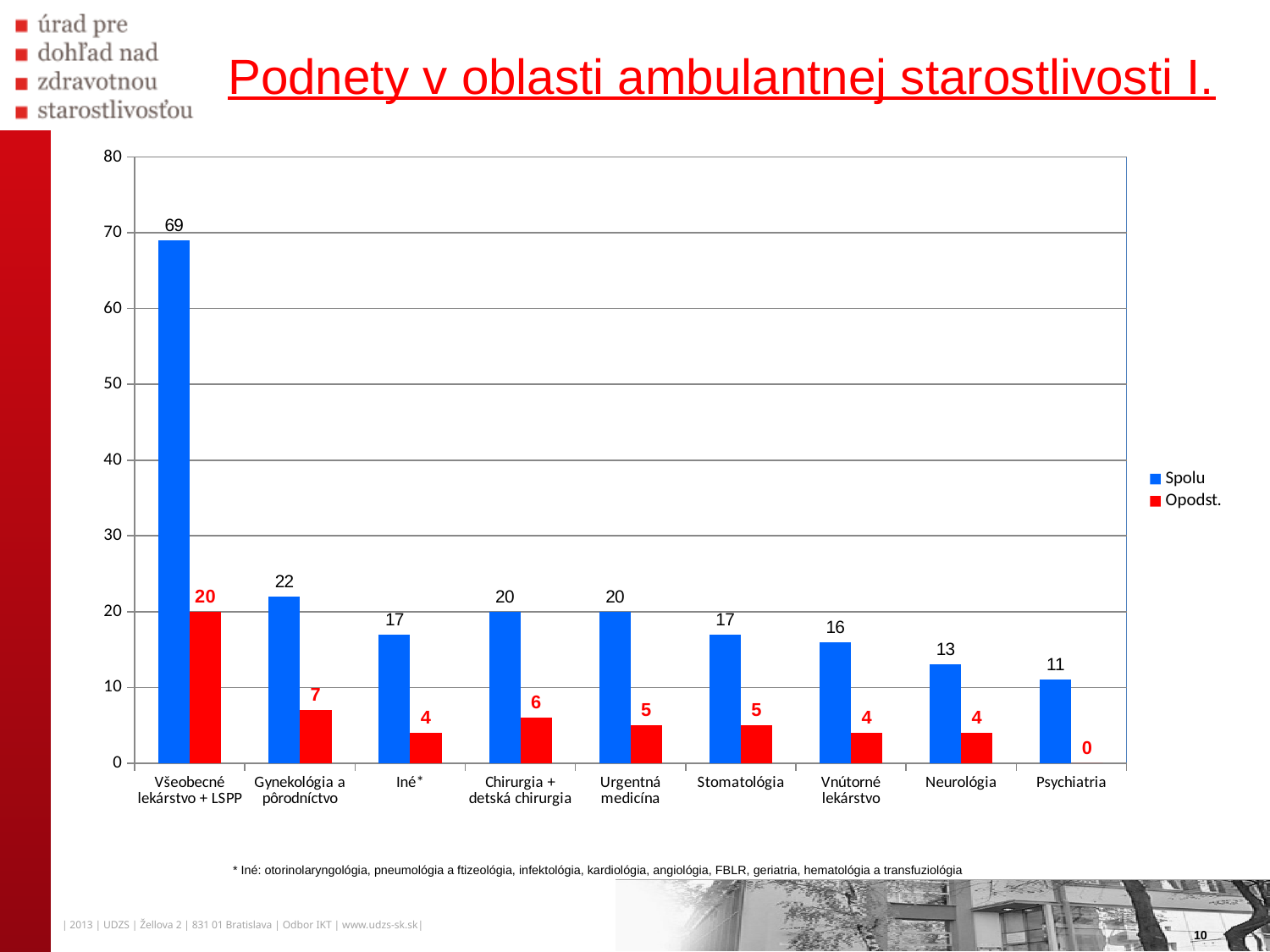
Which category has the lowest Spolu value? Psychiatria What is the difference between the Spolu and Opodst. values for Chirurgia + detská chirurgia? 14 What is the Spolu value for Všeobecné lekárstvo + LSPP? 69 What kind of chart is shown on the slide? bar chart How many categories are shown on the x axis? 9 Which category has the highest Spolu value? Všeobecné lekárstvo + LSPP Which is larger, the Spolu value for Stomatológia or the Spolu value for Neurológia? Stomatológia What is the Opodst. value for Gynekológia a pôrodníctvo? 7 What is the Spolu value for Vnútorné lekárstvo? 16 What is the Opodst. value for Psychiatria? 0 What colour are the Opodst. bars? red How many series does the legend list? 2